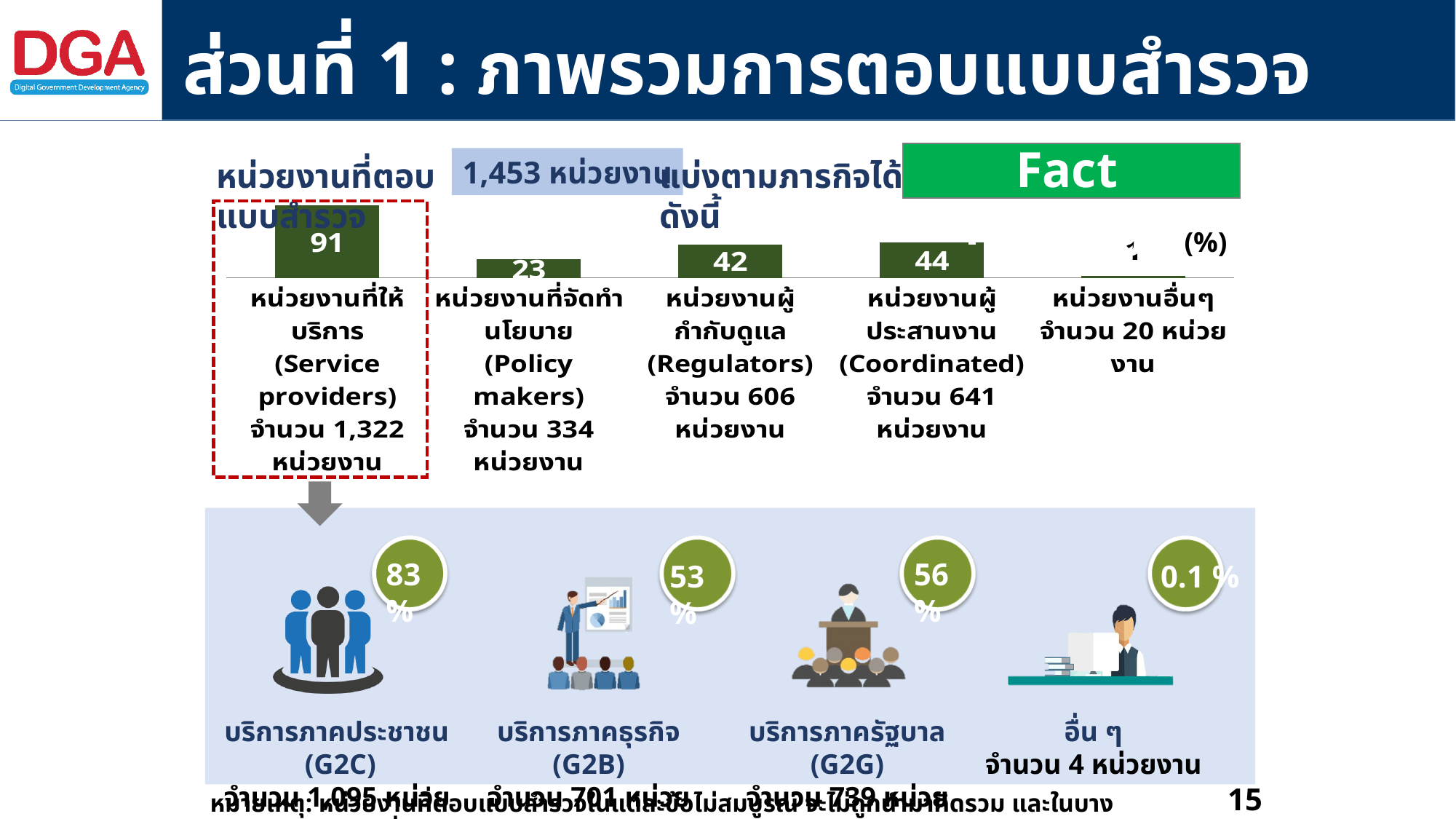
What is the value shown for the Policy makers bar in the bar chart? 23 How many bars are plotted in the bar chart? 5 What kind of chart is shown on the slide? bar chart What is the value shown for the Regulators bar in the bar chart? 42 What is the value shown for the Service providers bar in the bar chart? 91 Which category has the lowest bar in the bar chart? หน่วยงานอื่นๆ What is the difference between the Coordinated bar and the Regulators bar? 2 Which is larger in the bar chart, the Regulators bar or the Coordinated bar? Coordinated What is the value shown for the Coordinated bar in the bar chart? 44 Which category has the highest bar in the bar chart? หน่วยงานที่ให้บริการ (Service providers) What is the difference between the Service providers bar and the Policy makers bar? 68 What unit is indicated at the right of the bar chart? (%)